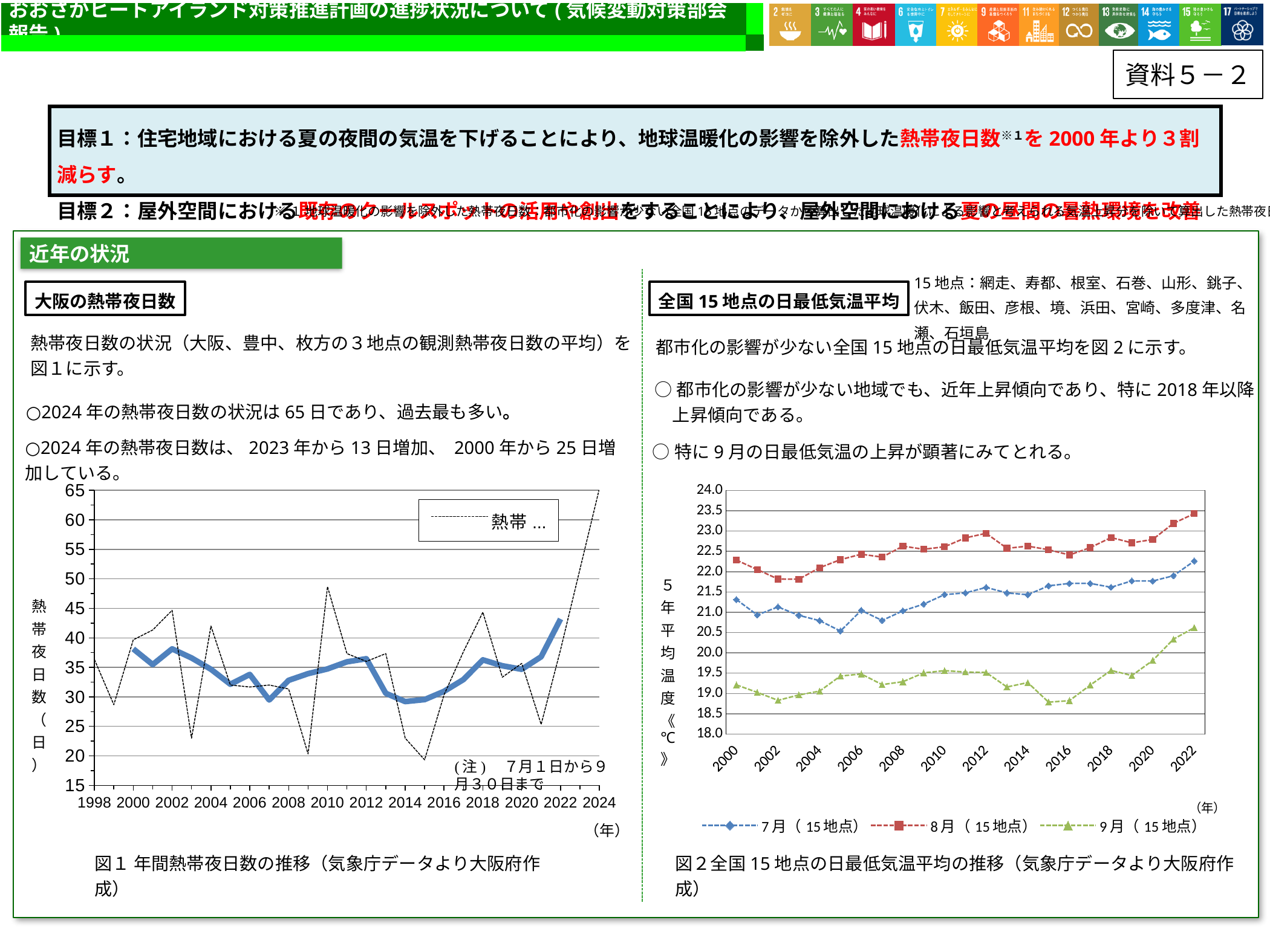
How many yearly data points does each series in 図2 全国15地点の日最低気温平均の推移 have (2000 to 2022)? 23 How many series does the legend of 図2 全国15地点の日最低気温平均の推移 list? 3 In 図1 年間熱帯夜日数の推移, which year has the highest number of 熱帯夜日数? 2024 In 図2 全国15地点の日最低気温平均の推移, is the 7月（15地点） value for 2005 greater or less than 21.0? less What kind of chart is 図1 年間熱帯夜日数の推移 on the left of the slide? line chart In 図2 全国15地点の日最低気温平均の推移, is the 8月（15地点） value for 2022 greater or less than 23.0? greater In 図1 年間熱帯夜日数の推移, what is the 熱帯夜日数 value for 2024? 65 In 図1 年間熱帯夜日数の推移, is the dashed-line value for 2010 greater or less than 45? greater In 図2 全国15地点の日最低気温平均の推移, which series has the highest values across all years? 8月（15地点） In 図2 全国15地点の日最低気温平均の推移, which series has the lowest values across all years? 9月（15地点） In 図2 全国15地点の日最低気温平均の推移, does the 9月（15地点） series rise or fall from 2016 to 2022? rise